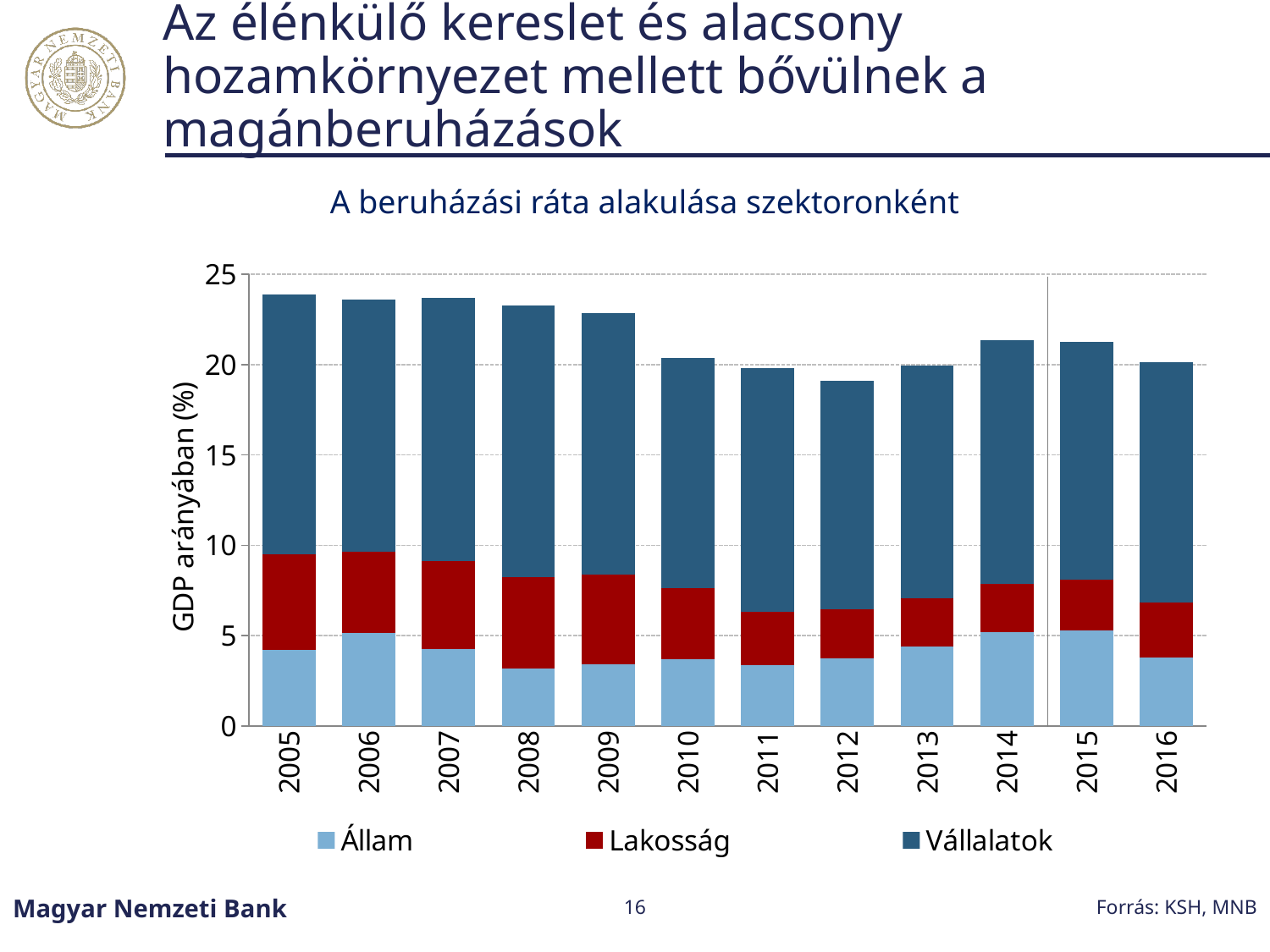
Is the total bar for 2012 greater or less than 20? less How many series does the legend list? 3 Is the Állam value for 2008 greater or less than 5? less Is the total bar for 2014 greater or less than 20? greater How many years are shown on the x axis? 12 What is the title of the chart? A beruházási ráta alakulása szektoronként Which is larger, the total bar for 2005 or the total bar for 2010? 2005 Which year has the lowest total investment rate? 2012 What is the label of the vertical axis? GDP arányában (%) Do the total bars rise or fall from 2005 to 2012? fall What kind of chart is shown on the slide? stacked bar chart